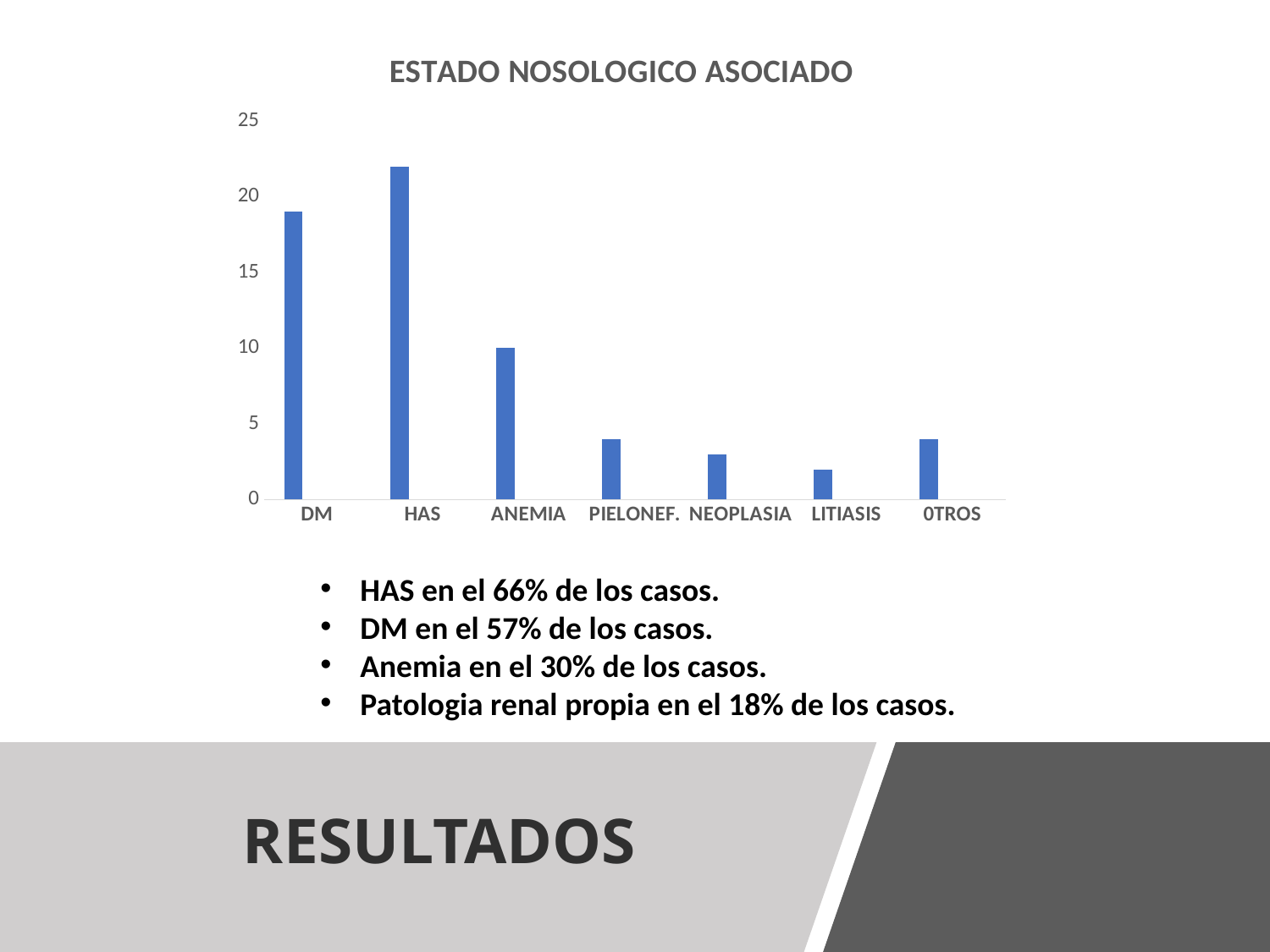
Is the value for LITIASIS greater or less than 5? less Is the value for ANEMIA greater or less than 15? less Is the value for NEOPLASIA greater or less than 5? less What is the title of the chart? ESTADO NOSOLOGICO ASOCIADO Which category has the lowest bar in the chart? LITIASIS Which category has the highest bar in the chart? HAS How many categories are shown on the x axis of the chart? 7 What kind of chart is shown on the slide? bar chart Which is larger, the value for HAS or the value for DM? HAS Which is larger, the value for ANEMIA or the value for PIELONEF.? ANEMIA